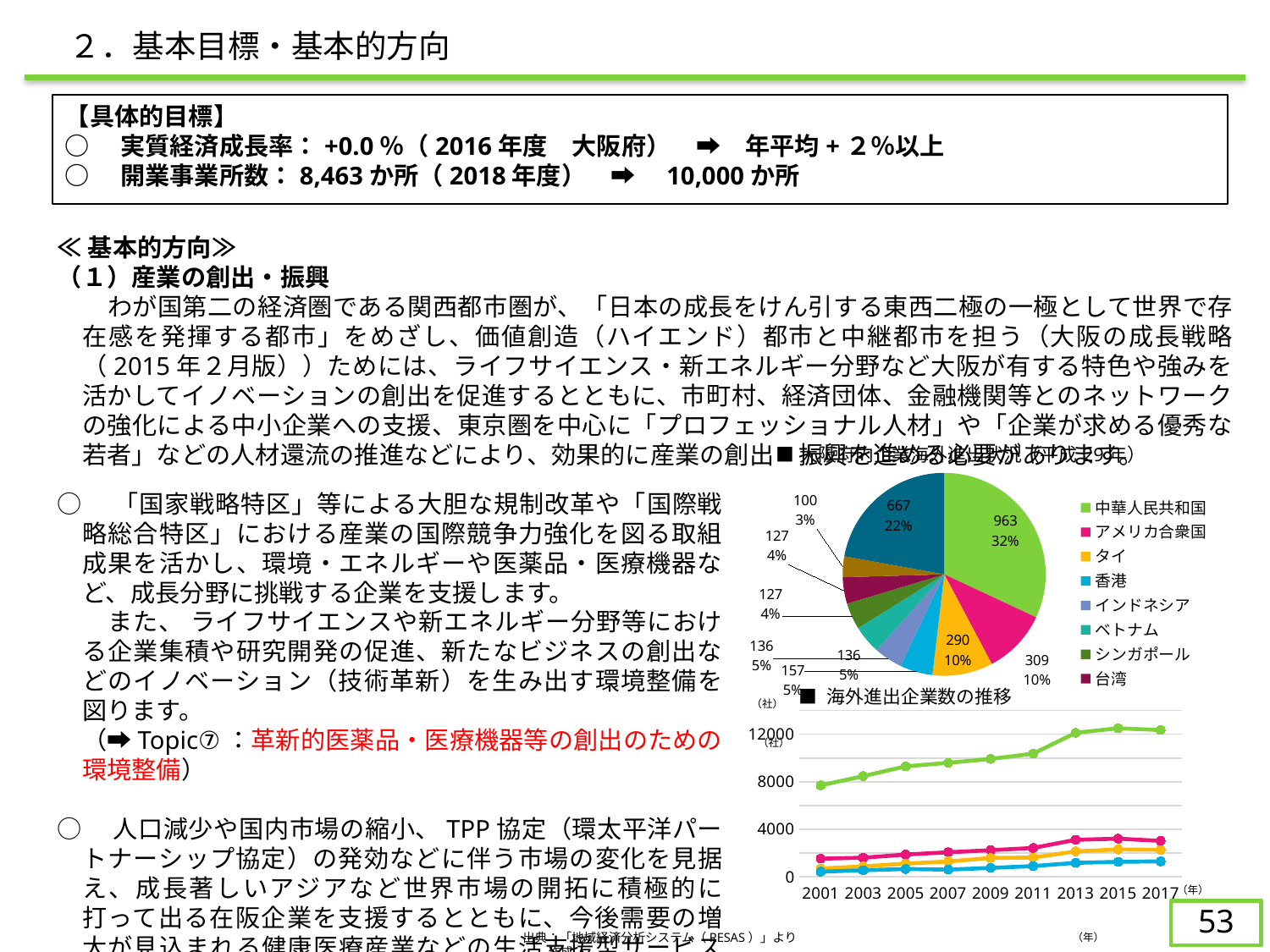
What kind of chart is the chart on the upper right of the slide showing 中華人民共和国, アメリカ合衆国 and other countries? pie chart What kind of chart is the chart titled 海外進出企業数の推移? line chart In the pie chart, how many entries does the legend list? 8 In the pie chart, which legend country has the largest slice? 中華人民共和国 In the pie chart, what share of the pie does 中華人民共和国 account for? 32% In the chart titled 海外進出企業数の推移, is the value of the top (green) line in 2009 greater or less than 8000? greater In the pie chart, what is the difference between the values for 中華人民共和国 and アメリカ合衆国? 654 In the pie chart, what share of the pie does タイ account for? 10% In the chart titled 海外進出企業数の推移, does the top (green) line rise or fall from 2001 to 2017? rise In the chart titled 海外進出企業数の推移, how many years are labeled on the x axis? 9 In the pie chart, what is the value shown for アメリカ合衆国? 309 In the pie chart, what is the value shown for 中華人民共和国? 963